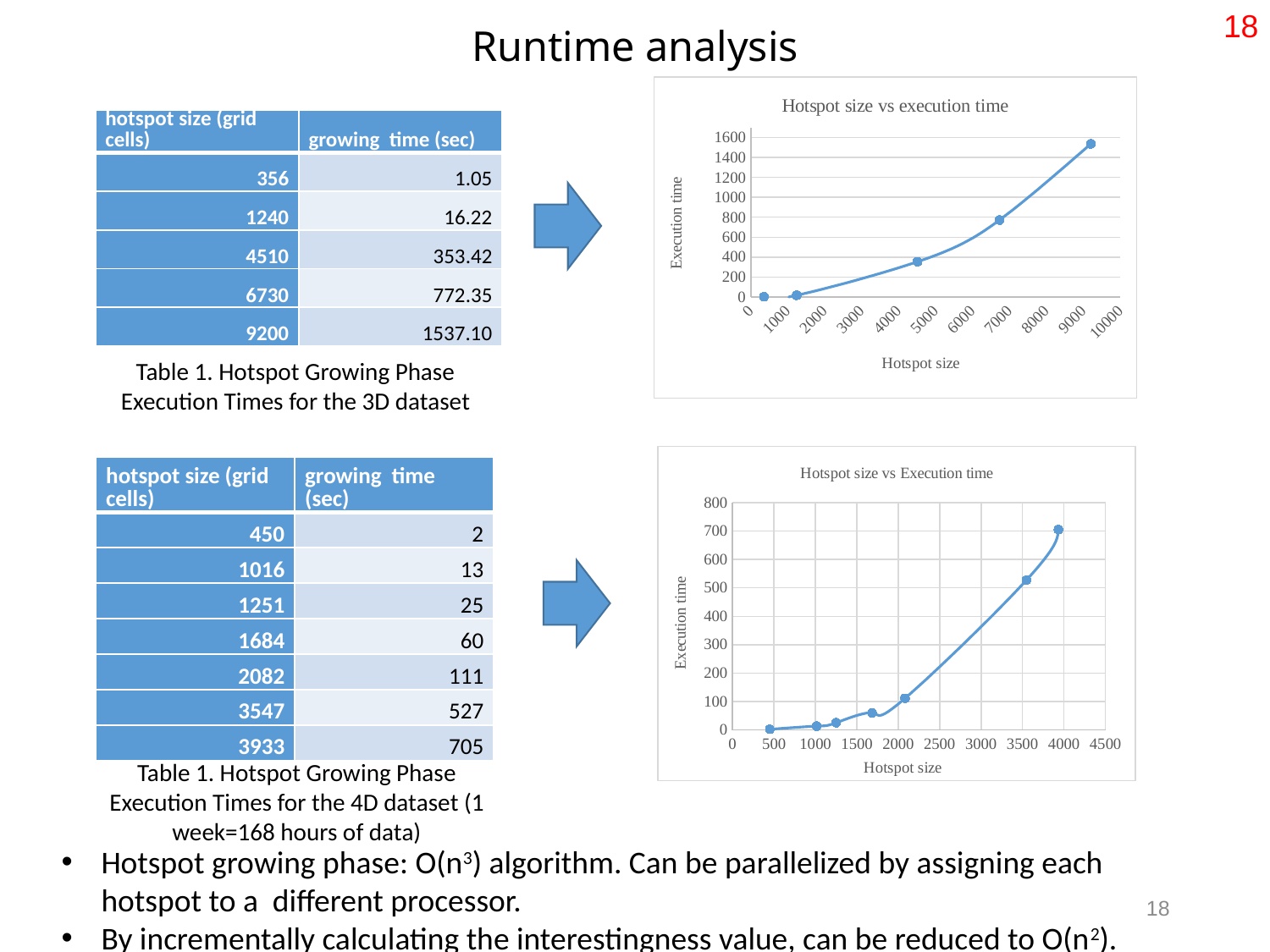
How many data points are plotted in the top chart 'Hotspot size vs execution time'? 5 In the bottom chart 'Hotspot size vs Execution time', does execution time rise or fall as hotspot size increases? Rises How many data points are plotted in the bottom chart 'Hotspot size vs Execution time'? 7 What type of chart is the top chart titled 'Hotspot size vs execution time'? Line chart What is the label of the y-axis in the top chart 'Hotspot size vs execution time'? Execution time In the top chart 'Hotspot size vs execution time', is the execution time for the largest hotspot size greater or less than 1400? greater What is the highest tick value shown on the x-axis of the bottom chart 'Hotspot size vs Execution time'? 4500 In the top chart 'Hotspot size vs execution time', does execution time rise or fall as hotspot size increases? Rises In the bottom chart 'Hotspot size vs Execution time', is the execution time for the hotspot size near 2000 greater or less than 200? less In the top chart 'Hotspot size vs execution time', is the execution time for the hotspot size between 4000 and 5000 greater or less than 400? less